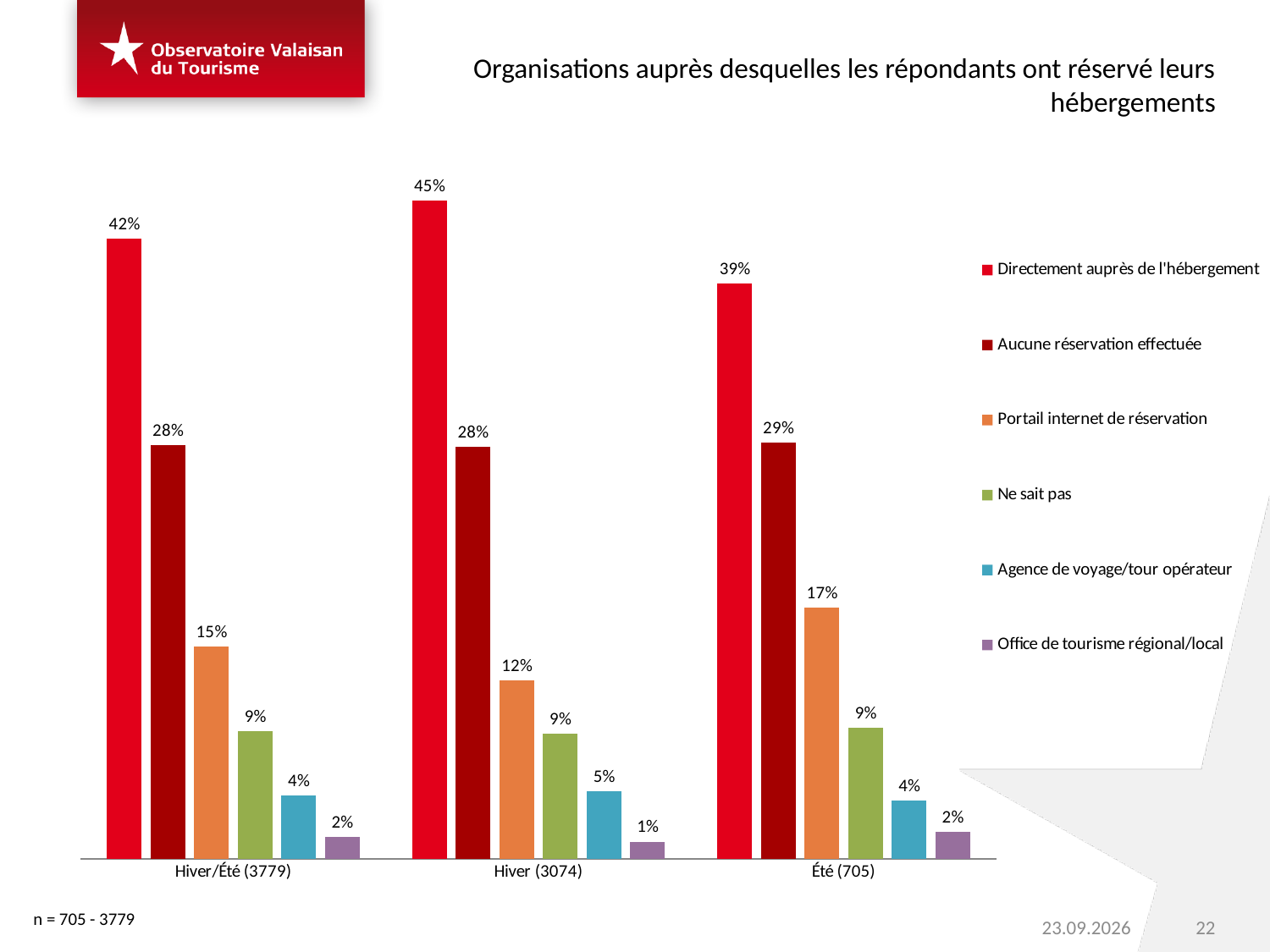
Which is larger: "Portail internet de réservation" in Hiver (3074) or in Été (705)? Été (705) What is the value for "Office de tourisme régional/local" in the Hiver (3074) group? 1% How many groups are shown on the x axis? 3 What is the value for "Directement auprès de l'hébergement" in the Hiver (3074) group? 45% What is the title of the chart? Organisations auprès desquelles les répondants ont réservé leurs hébergements What is the value for "Portail internet de réservation" in the Été (705) group? 17% Which series has the lowest value in the Hiver/Été (3779) group? Office de tourisme régional/local What is the difference between "Directement auprès de l'hébergement" and "Aucune réservation effectuée" in the Été (705) group? 10% What colour represents "Ne sait pas" in the legend? Green Which group has the highest value for "Directement auprès de l'hébergement"? Hiver (3074) How many series does the legend list? 6 What kind of chart is shown on the slide? Bar chart